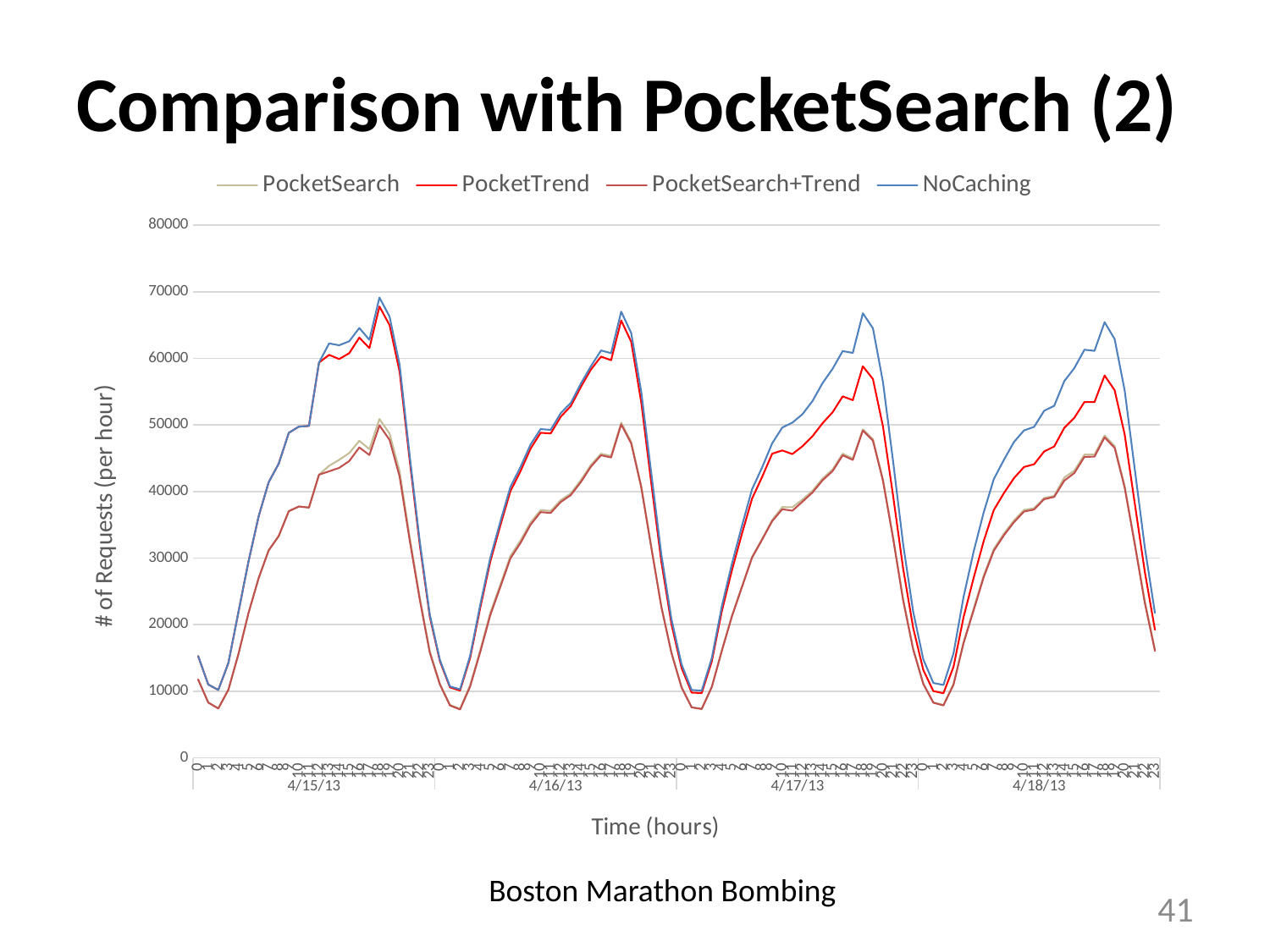
How many series does the legend list? 4 Which series is plotted highest across the chart? NoCaching How many dates are labelled on the x axis? 4 Is the peak value of PocketSearch+Trend on 4/17/13 greater or less than 60000? less What is the title of the x axis? Time (hours) At the peak on 4/17/13, which series is larger, NoCaching or PocketTrend? NoCaching At the peak on 4/16/13, which series is larger, PocketTrend or PocketSearch+Trend? PocketTrend Is the peak value of PocketTrend on 4/18/13 greater or less than 50000? greater Is the lowest value of PocketSearch+Trend on 4/16/13 greater or less than 20000? less What is the title of the y axis? # of Requests (per hour) What kind of chart is shown on the slide? line chart